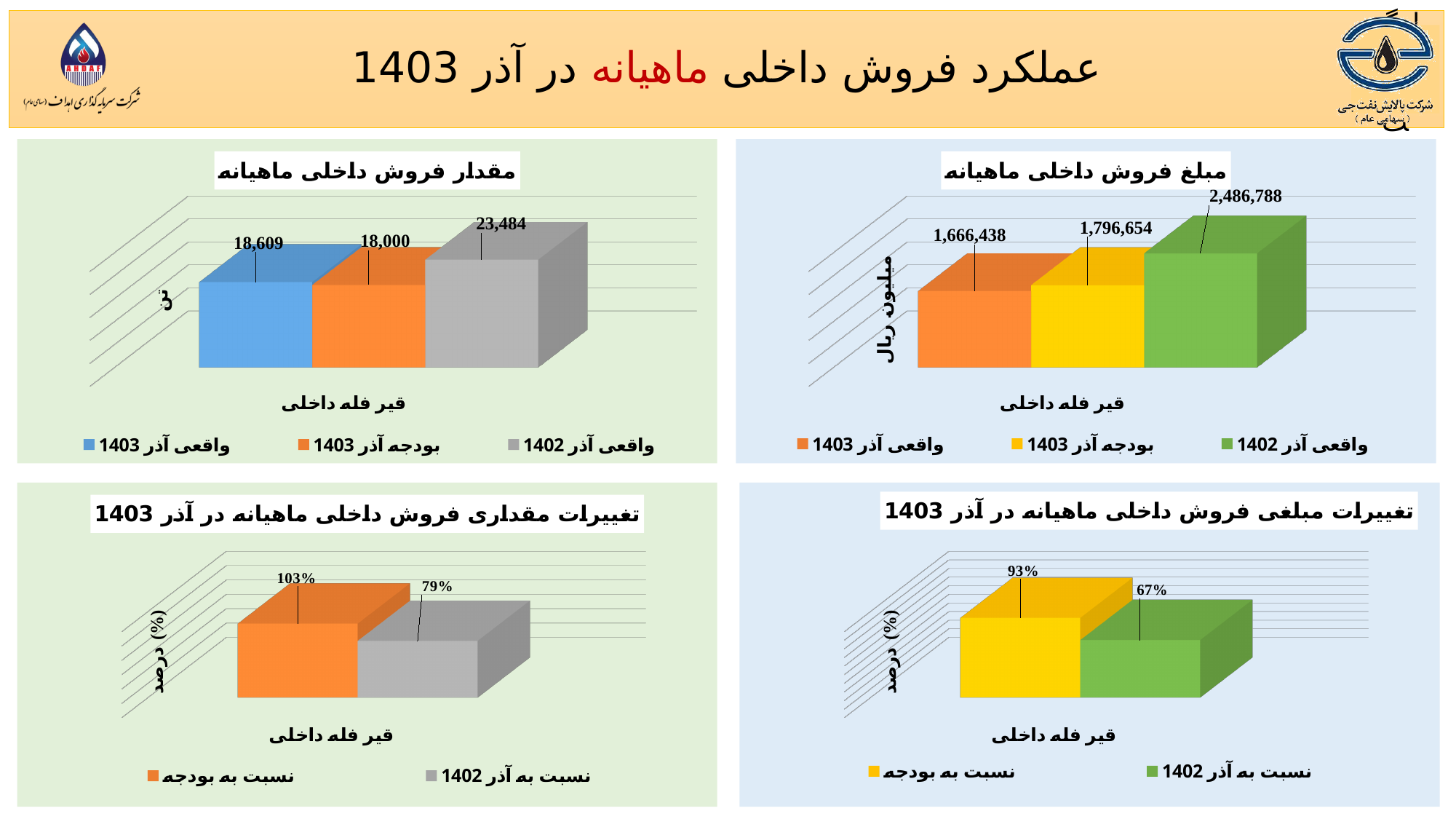
In the top-left chart (مقدار فروش داخلی ماهیانه), what is the value for واقعی آذر 1403? 18,609 In the top-left chart (مقدار فروش داخلی ماهیانه), what is the difference between واقعی آذر 1402 and واقعی آذر 1403? 4,875 In the top-right chart (مبلغ فروش داخلی ماهیانه), which series has the lowest value? واقعی آذر 1403 In the top-left chart (مقدار فروش داخلی ماهیانه), which series has the highest value? واقعی آذر 1402 In the bottom-right chart (تغییرات مبلغی فروش داخلی ماهیانه در آذر 1403), what is the value for نسبت به آذر 1402? 67% In the top-right chart (مبلغ فروش داخلی ماهیانه), what is the value for واقعی آذر 1402? 2,486,788 In the top-left chart (مقدار فروش داخلی ماهیانه), what is the value for بودجه آذر 1403? 18,000 In the top-right chart (مبلغ فروش داخلی ماهیانه), what is the difference between بودجه آذر 1403 and واقعی آذر 1403? 130,216 In the bottom-left chart (تغییرات مقداری فروش داخلی ماهیانه در آذر 1403), what is the value for نسبت به بودجه? 103% How many series does the legend of the top-right chart (مبلغ فروش داخلی ماهیانه) list? 3 In the bottom-right chart (تغییرات مبلغی فروش داخلی ماهیانه در آذر 1403), which is larger: نسبت به بودجه or نسبت به آذر 1402? نسبت به بودجه What kind of chart is the bottom-left chart (تغییرات مقداری فروش داخلی ماهیانه در آذر 1403)? Bar chart